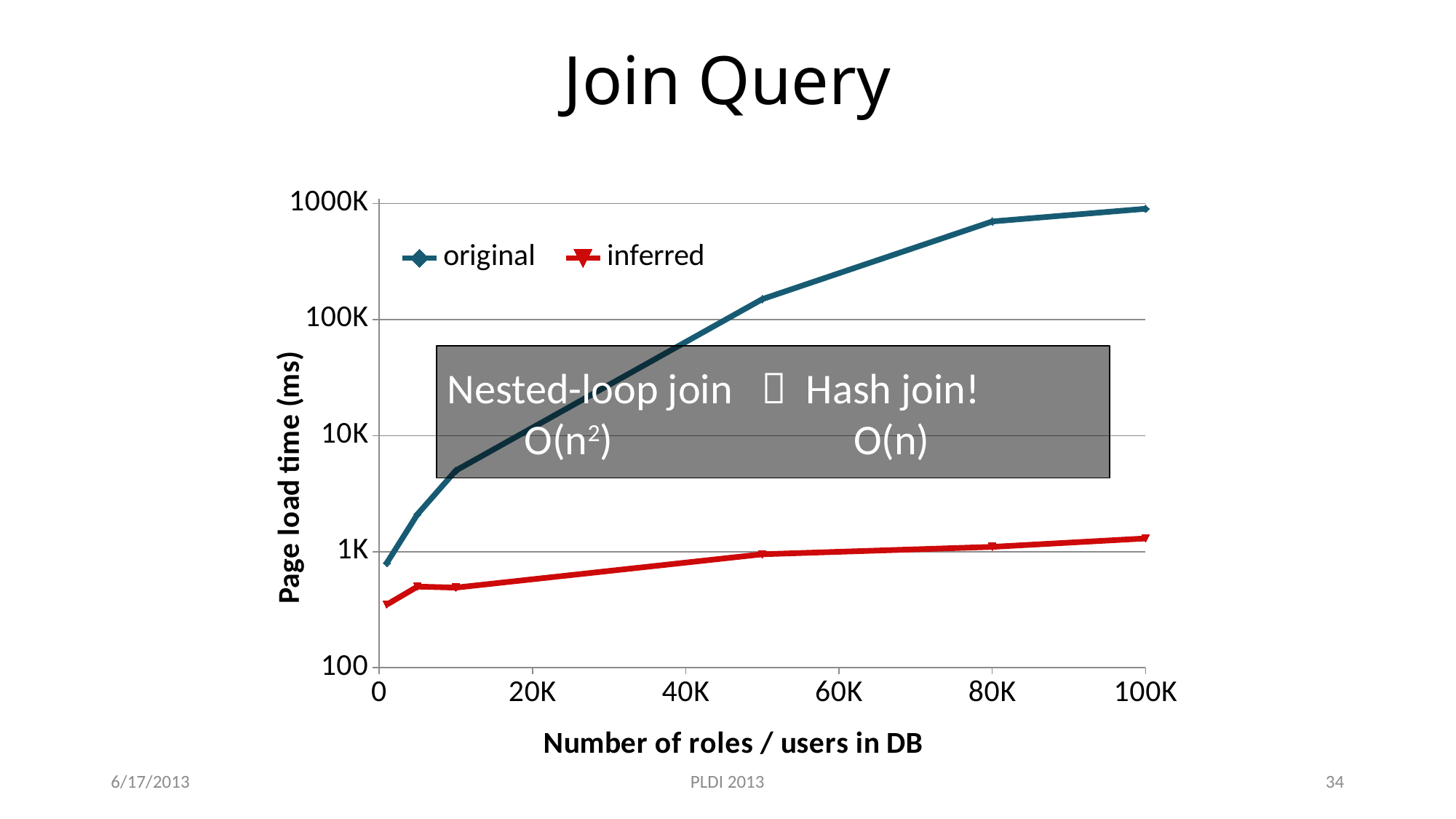
Is the value for the inferred series at 100K greater or less than 10K ms? less What is the label of the y axis? Page load time (ms) At 100K roles/users, which series has the higher page load time, original or inferred? original Which series reaches the highest page load time on the chart? original Is the value for the original series at 50K greater or less than 100K ms? greater Is the value for the original series at 10K greater or less than 1K ms? greater Does the original series rise or fall as the number of roles/users increases? rise What are the two series named in the legend? original and inferred How many series does the legend list? 2 What kind of chart is shown on the slide? line chart